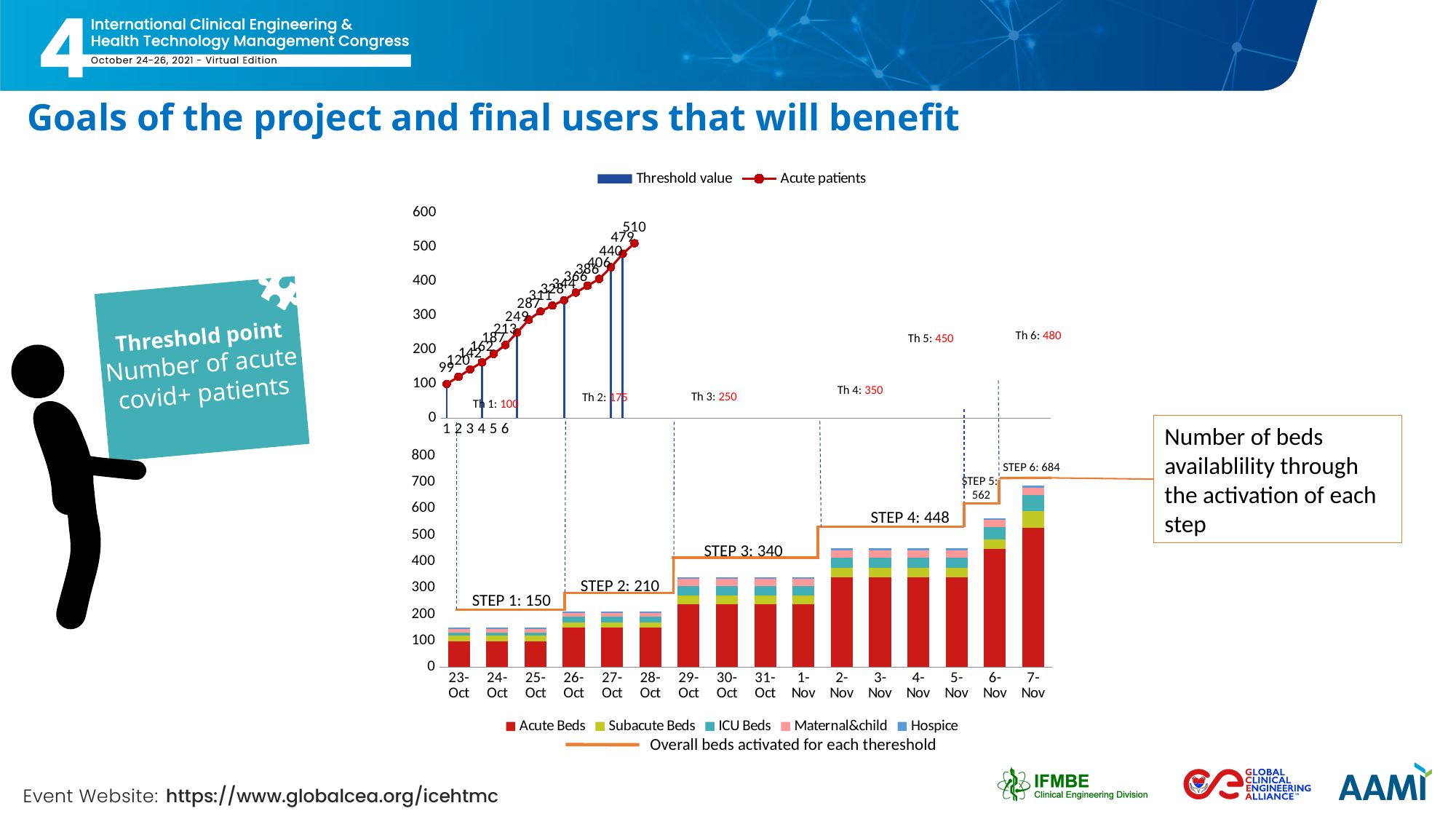
What kind of chart is the bottom chart? stacked bar chart In the top chart, what is the difference between Th 2 and Th 1? 75 In the top chart, what is the value of Th 3? 250 In the bottom chart, what is the difference between STEP 6 and STEP 5? 122 In the bottom chart, how many bed categories does the legend list? 5 In the top chart, what is the value of Th 6? 480 In the bottom chart, how many dates are shown on the x axis? 16 In the top chart, what is the highest labelled value of Acute patients? 510 In the top chart, do the Acute patients values rise or fall along the x axis? rise In the bottom chart, what is the value labelled for STEP 4? 448 In the bottom chart, is the total bar for 7-Nov greater or less than 600? greater In the top chart, how many series does the legend list? 2